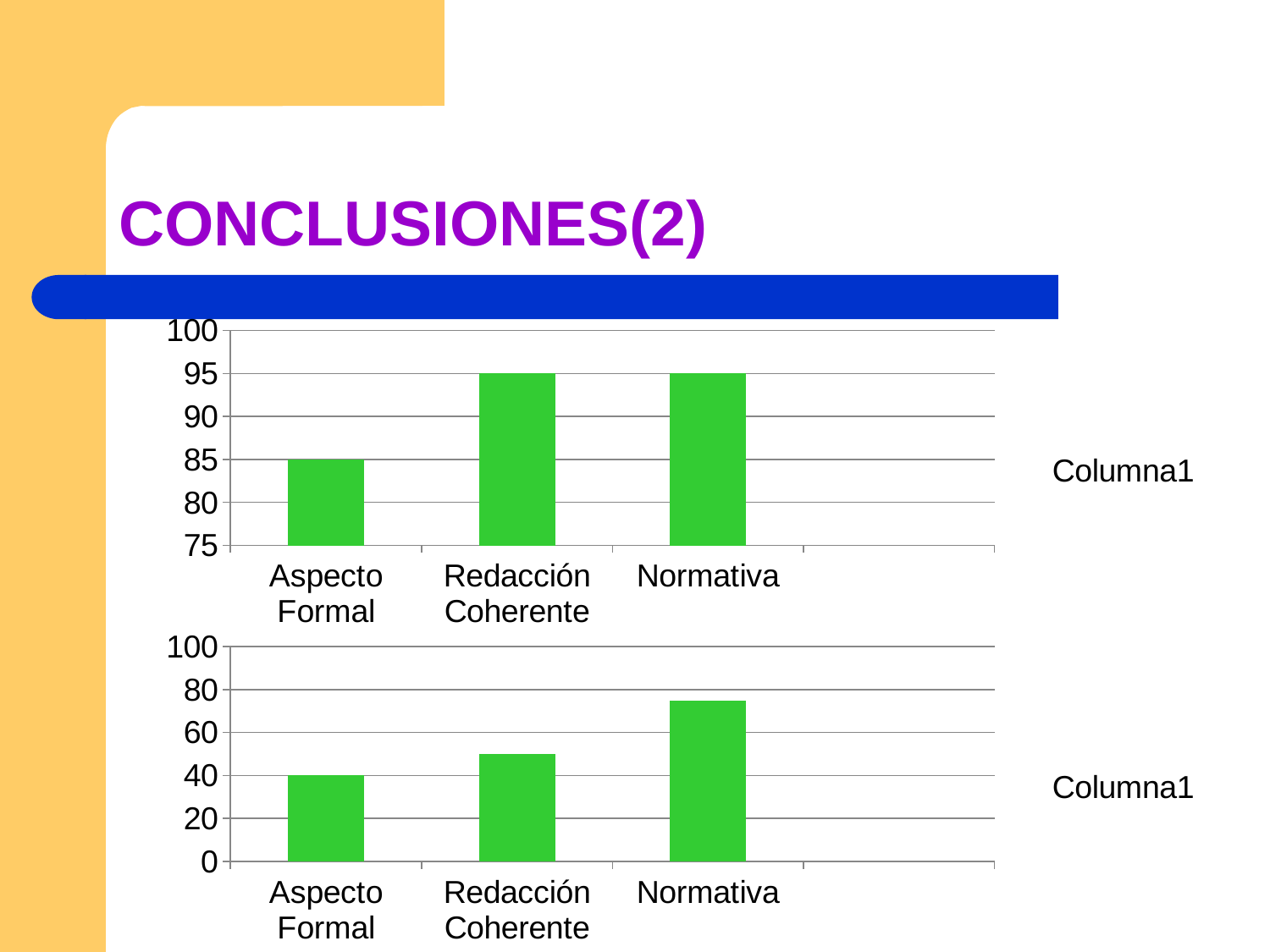
In the bottom chart, what is the value for Aspecto Formal? 40 In the top chart, which category has the lowest value? Aspecto Formal In the bottom chart, is the value for Normativa greater or less than 60? greater In the bottom chart, do the values rise or fall from Aspecto Formal to Normativa? rise What kind of chart is the top chart? Bar chart In the top chart, what is the value for Aspecto Formal? 85 In the top chart, what is the value for Redacción Coherente? 95 In the top chart, what is the difference between the values for Redacción Coherente and Aspecto Formal? 10 How many categories are shown in the top chart? 3 In the bottom chart, which category has the highest value? Normativa In the bottom chart, is the value for Redacción Coherente greater or less than 60? less What series name does the legend of the bottom chart show? Columna1